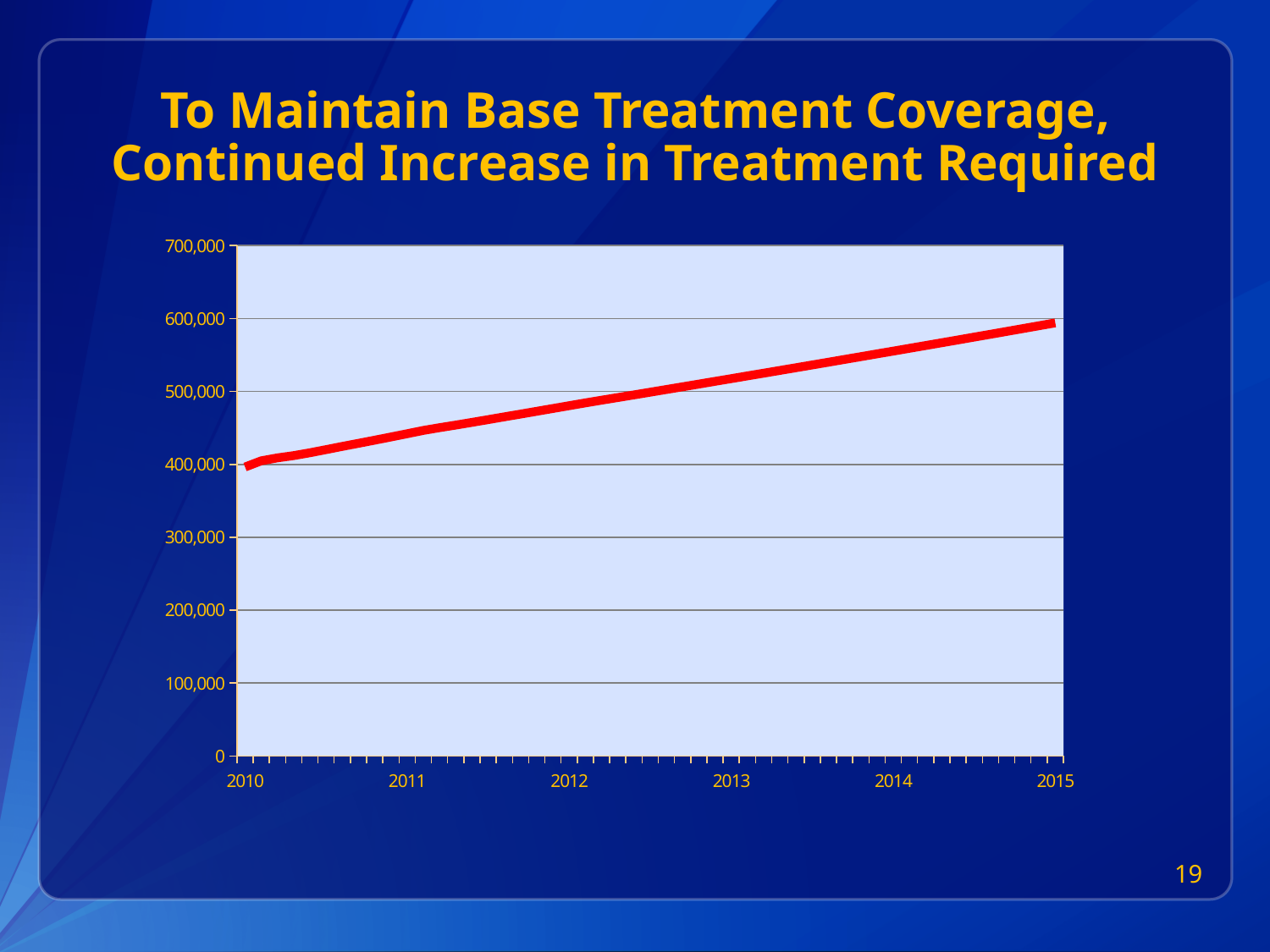
What is the title of the slide containing the chart? To Maintain Base Treatment Coverage, Continued Increase in Treatment Required Which is larger, the value for 2015 or the value for 2010? 2015 Is the value for 2013 greater or less than 400,000? greater Is the value for 2015 greater or less than 500,000? greater Does the plotted value rise or fall from 2010 to 2015? rise Which year has the lowest plotted value? 2010 What colour is the plotted line? red How many year labels are shown on the x axis? 6 What kind of chart is shown on the slide? line chart Is the value for 2011 greater or less than 600,000? less Which year has the highest plotted value? 2015